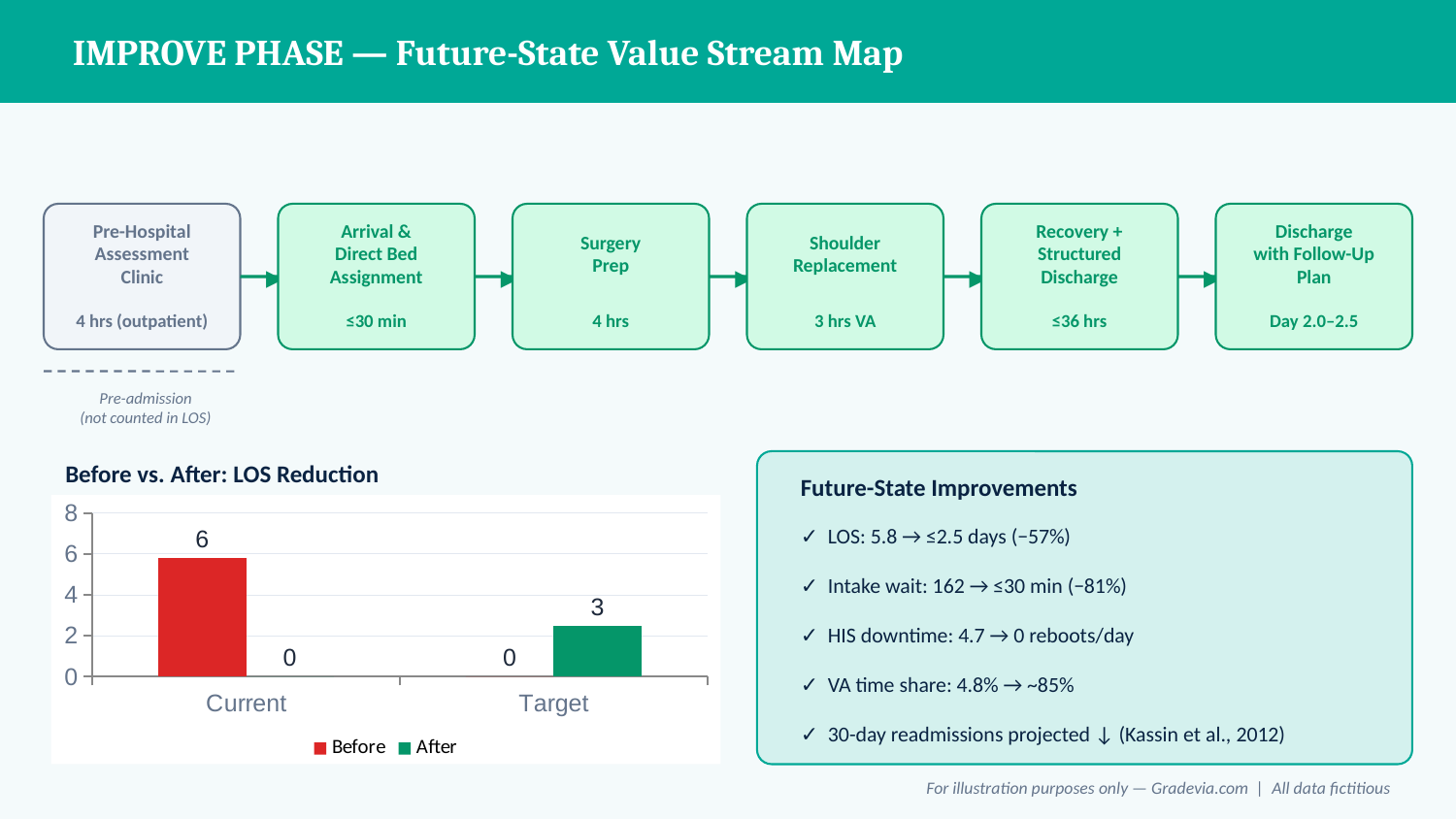
How many series does the legend of the "Before vs. After: LOS Reduction" chart list? 2 In the "Before vs. After: LOS Reduction" chart, what is the data label for the After series at Target? 3 In the "Before vs. After: LOS Reduction" chart, is the Before value at Current greater or less than 4? greater In the "Before vs. After: LOS Reduction" chart, is the After value at Target greater or less than 4? less What is the title of the chart on the slide? Before vs. After: LOS Reduction In the "Before vs. After: LOS Reduction" chart, what is the data label for the Before series at Target? 0 In the "Before vs. After: LOS Reduction" chart, which is larger: the Before value at Current or the After value at Target? Before value at Current In the "Before vs. After: LOS Reduction" chart, what is the data label for the Before series at Current? 6 In the "Before vs. After: LOS Reduction" chart, what colour represents the After series? green In the "Before vs. After: LOS Reduction" chart, what is the data label for the After series at Current? 0 How many categories are shown on the x axis of the "Before vs. After: LOS Reduction" chart? 2 What type of chart is shown under "Before vs. After: LOS Reduction"? bar chart